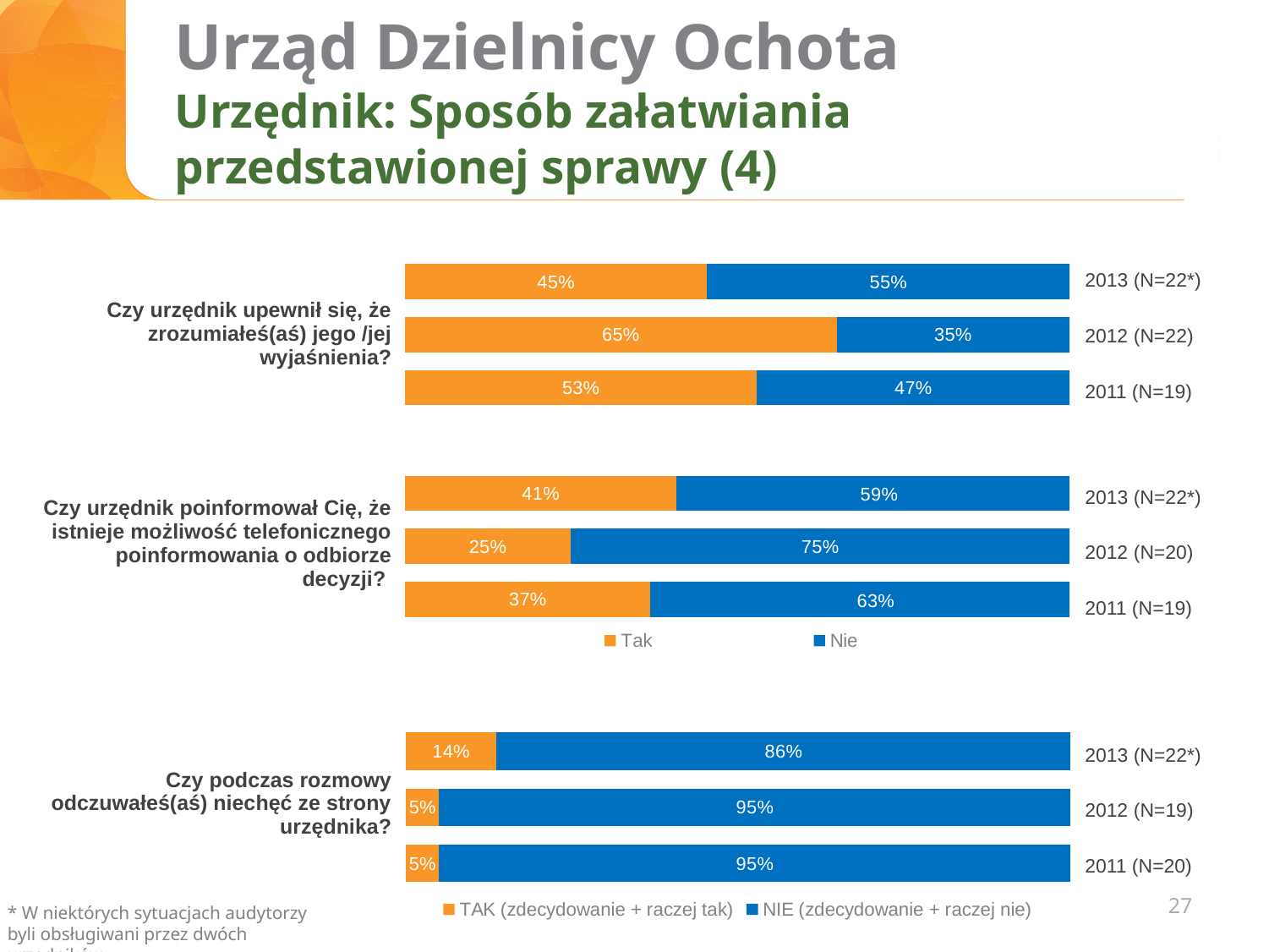
How many years (bars) are shown in each of the three charts? 3 In the bottom chart ("Czy podczas rozmowy odczuwałeś(aś) niechęć..."), what is the "NIE" value for 2011 (N=20)? 95% In the top chart ("Czy urzędnik upewnił się, że zrozumiałeś(aś) jego /jej wyjaśnienia?"), what is the "Tak" value for 2013 (N=22*)? 45% How many series does the legend of the bottom chart list? 2 In the middle chart ("Czy urzędnik poinformował Cię..."), is the "Tak" value for 2013 larger or smaller than the "Tak" value for 2011? larger In the middle chart ("Czy urzędnik poinformował Cię, że istnieje możliwość telefonicznego poinformowania o odbiorze decyzji?"), what is the "Nie" value for 2012 (N=20)? 75% In the top chart ("Czy urzędnik upewnił się..."), what is the difference between the "Tak" values for 2012 and 2013? 20 percentage points In the bottom chart ("Czy podczas rozmowy odczuwałeś(aś) niechęć ze strony urzędnika?"), what is the "TAK" value for 2013 (N=22*)? 14% In the middle chart ("Czy urzędnik poinformował Cię..."), which year has the lowest "Tak" share? 2012 (N=20) In the top chart ("Czy urzędnik upewnił się..."), which year has the highest "Tak" share? 2012 (N=22) What type of chart is used on this slide? Stacked bar chart In the top chart ("Czy urzędnik upewnił się..."), what is the "Nie" value for 2012 (N=22)? 35%